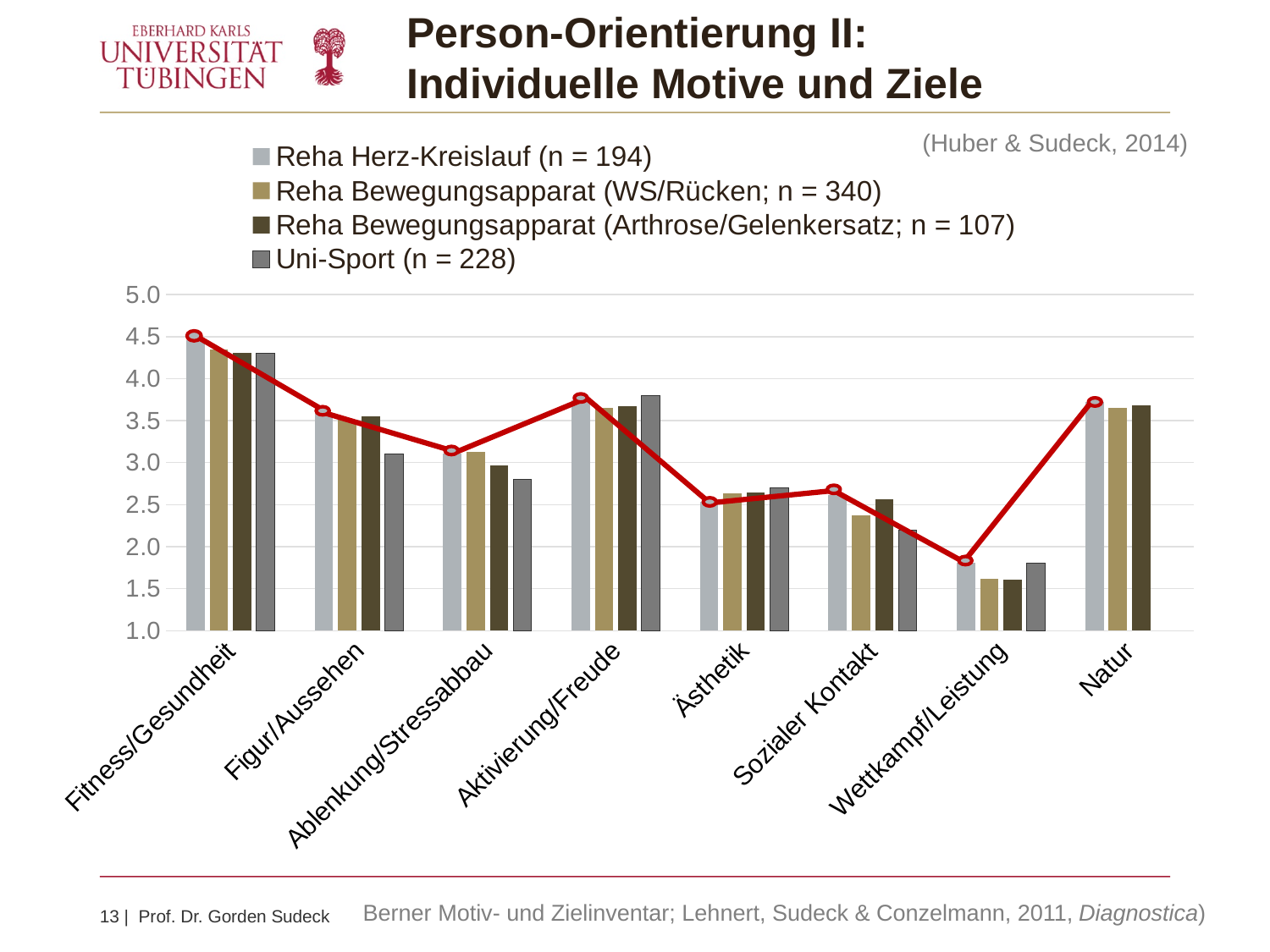
At Figur/Aussehen, which is larger: the value for Reha Bewegungsapparat (WS/Rücken; n = 340) or for Uni-Sport (n = 228)? Reha Bewegungsapparat (WS/Rücken; n = 340) Is the value for Uni-Sport (n = 228) at Ablenkung/Stressabbau greater or less than 3.0? less Which category has the highest value for Reha Herz-Kreislauf (n = 194)? Fitness/Gesundheit Which series is listed first in the legend? Reha Herz-Kreislauf (n = 194) Which category has the lowest value for Uni-Sport (n = 228)? Wettkampf/Leistung How many series does the legend list? 4 Is the value for Uni-Sport (n = 228) at Wettkampf/Leistung greater or less than 2.0? less How many categories are shown on the x axis? 8 What kind of chart is shown on the slide? bar chart Which category has the lowest value for Reha Herz-Kreislauf (n = 194)? Wettkampf/Leistung Is the value for Uni-Sport (n = 228) at Sozialer Kontakt greater or less than 2.5? less